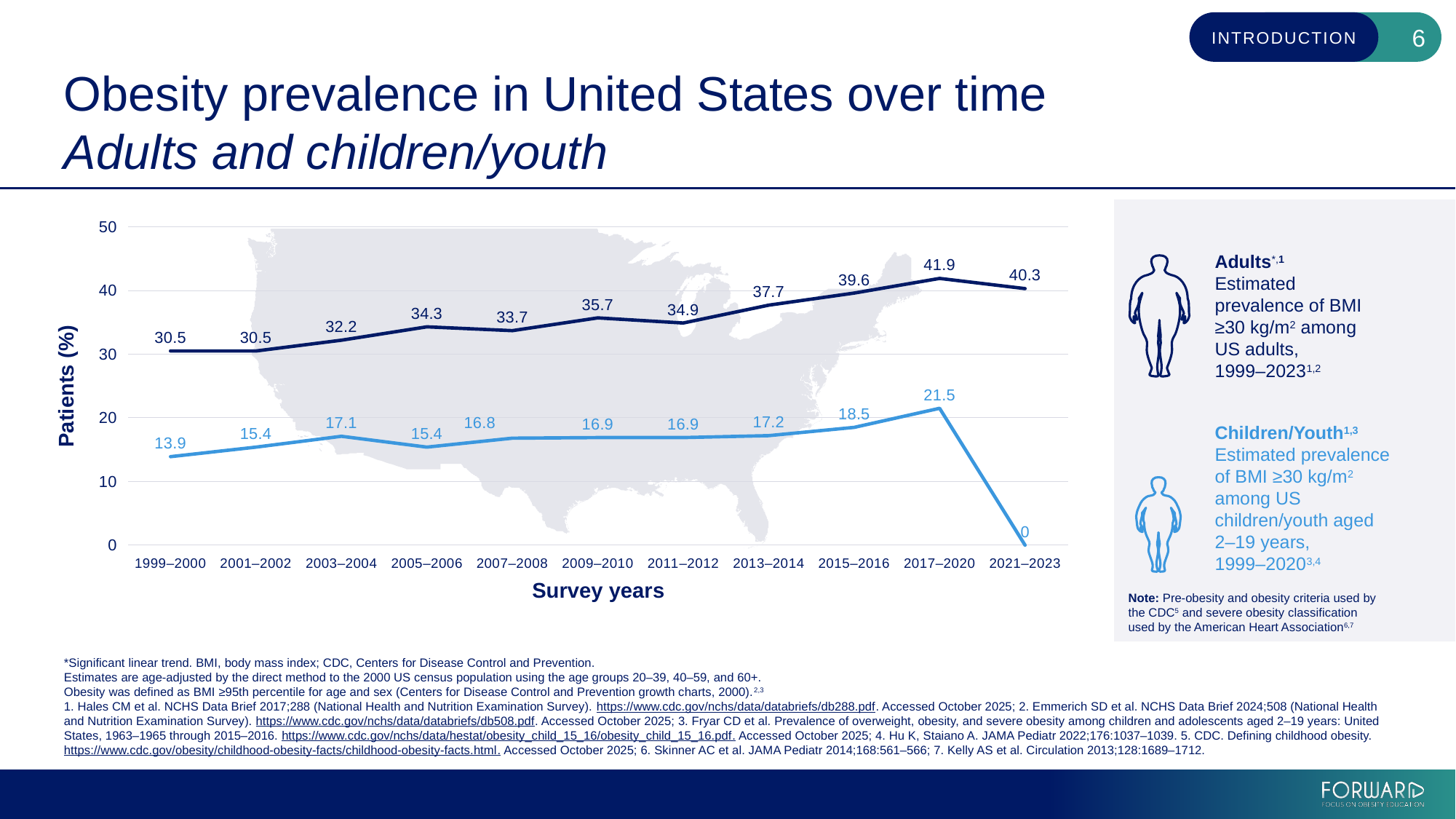
How much higher is the children/youth value for 2017–2020 than for 2015–2016? 3.0 What is the title of the x axis of the chart? Survey years Which survey period has the larger adults value, 2007–2008 or 2009–2010? 2009–2010 What kind of chart is shown on the slide? line chart What is the difference between the adults values for 2017–2020 and 2021–2023? 1.6 What is the children/youth obesity prevalence value for the 1999–2000 survey years? 13.9 In which survey years does the adults line reach its highest value? 2017–2020 What is the adults obesity prevalence value for the 2017–2020 survey years? 41.9 Does the adults line rise or fall from 1999–2000 to 2017–2020? rise What is the lowest value shown on the adults line? 30.5 How many survey-year categories are shown on the x axis? 11 Is the adults value for 2013–2014 greater or less than 40? less